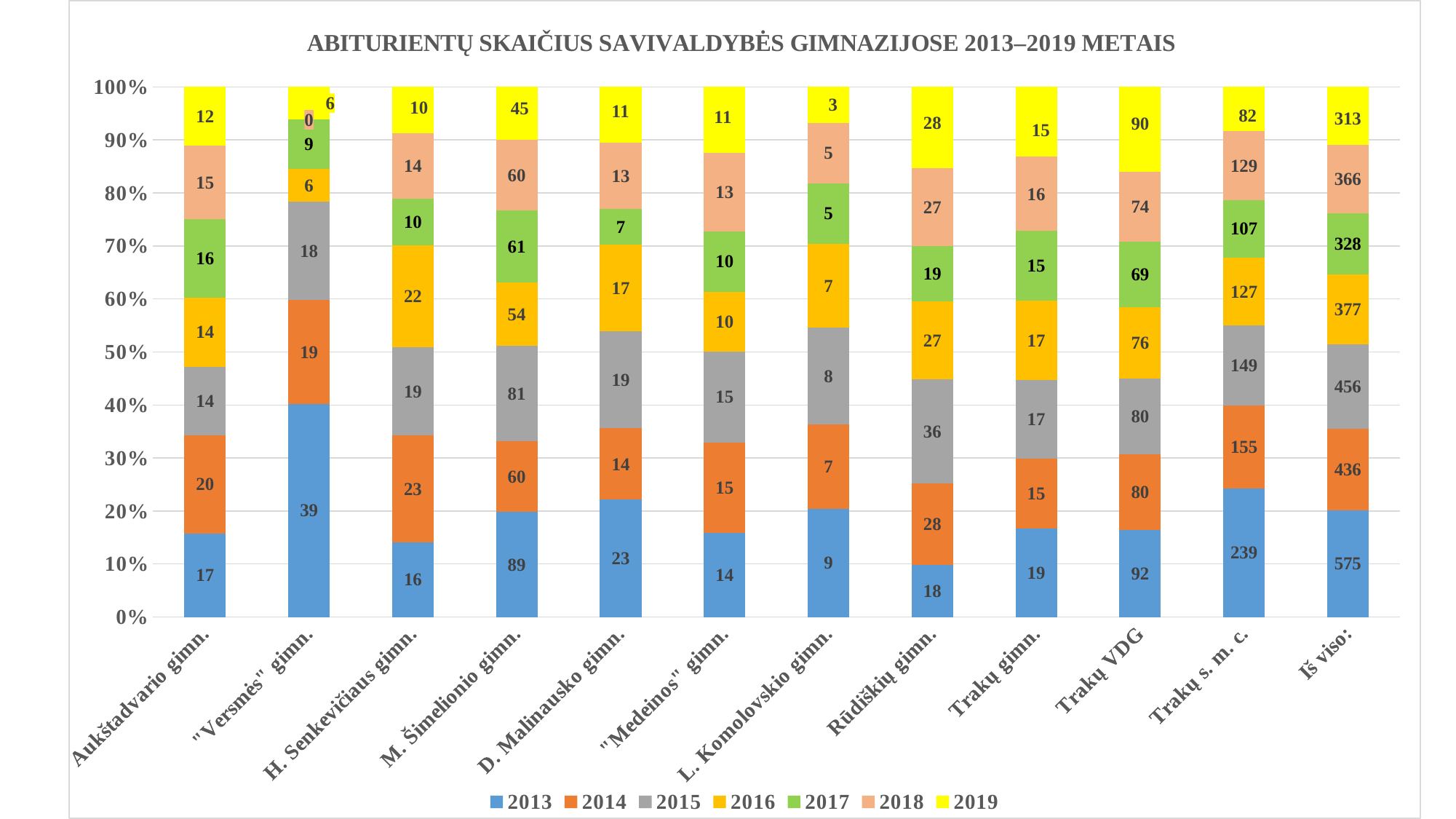
What is the value for M. Šimelionio gimn. in 2017? 61 What is the title of the chart? ABITURIENTŲ SKAIČIUS SAVIVALDYBĖS GIMNAZIJOSE 2013–2019 METAIS How many series does the legend list? 7 Which year has the lowest value for L. Komolovskio gimn.? 2019 Which year has the highest value for Trakų s. m. c.? 2013 What is the total of all years for Aukštadvario gimn.? 108 Which is larger: the 2014 value for Rūdiškių gimn. or the 2014 value for H. Senkevičiaus gimn.? Rūdiškių gimn. How many categories are shown along the x axis? 12 What is the value for Trakų VDG in 2013? 92 What is the difference between the 2013 and 2019 values for Trakų s. m. c.? 157 What is the value for Iš viso: in 2019? 313 What type of chart is shown on the slide? stacked bar chart